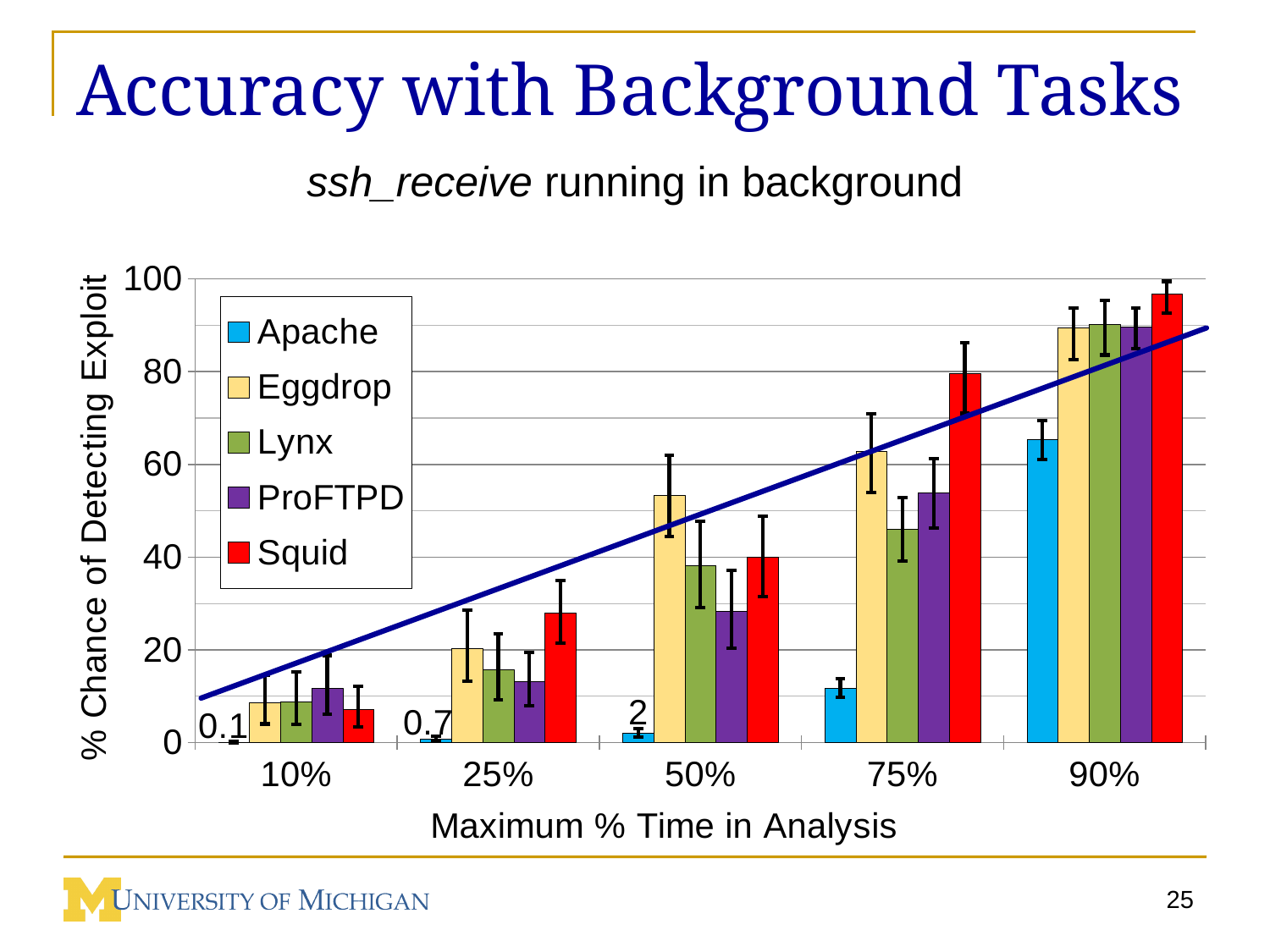
Do the Squid values rise or fall as Maximum % Time in Analysis increases? rise What is the value for Apache at 10% Maximum % Time in Analysis? 0.1 What is the difference between the Apache values at 50% and at 10%? 1.9 Which series has the highest value at 75%? Squid Which series has the lowest value at 50%? Apache Is the value for Squid at 90% greater or less than 80? greater What is the value for Apache at 50% Maximum % Time in Analysis? 2 Is the value for Apache at 75% greater or less than 20? less How many categories are shown on the x axis? 5 What kind of chart is shown on the slide? bar chart How many series does the legend list? 5 What is the value for Apache at 25% Maximum % Time in Analysis? 0.7